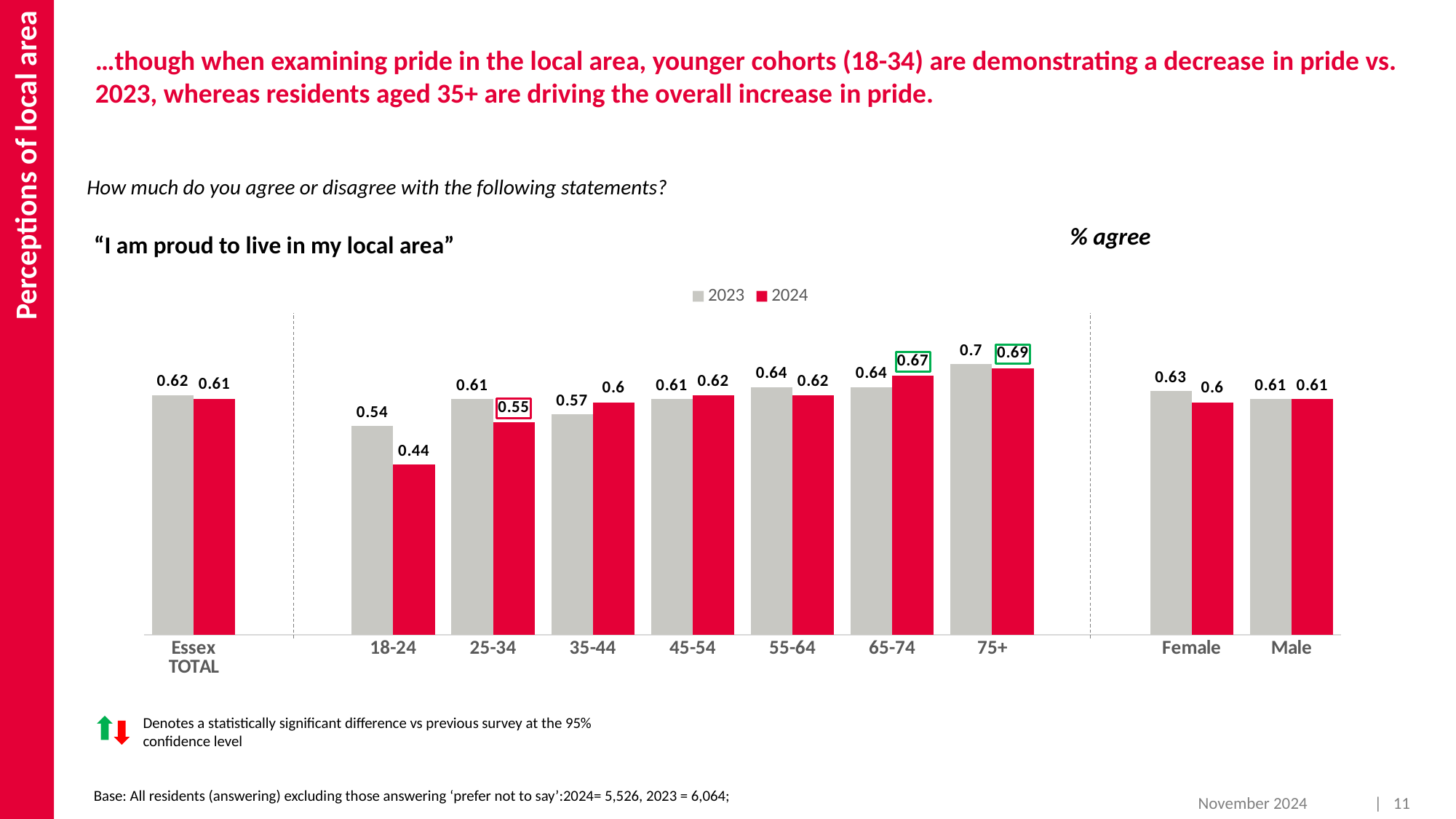
Which category has the lowest 2024 value? 18-24 What is the 2024 value for the 65-74 age group? 0.67 What is the difference between the 2023 and 2024 values for the 18-24 age group? 0.1 What kind of chart is shown on the slide? Bar chart How many series does the legend list? 2 Which colour represents the 2024 series in the chart? Red What is the 2024 value for the 18-24 age group? 0.44 What is the difference between the 2023 and 2024 values for the 25-34 age group? 0.06 What is the 2023 value for Essex TOTAL? 0.62 What is the 2023 value for Female? 0.63 Which category has the highest 2023 value? 75+ For the 35-44 age group, which is larger, the 2023 value or the 2024 value? 2024